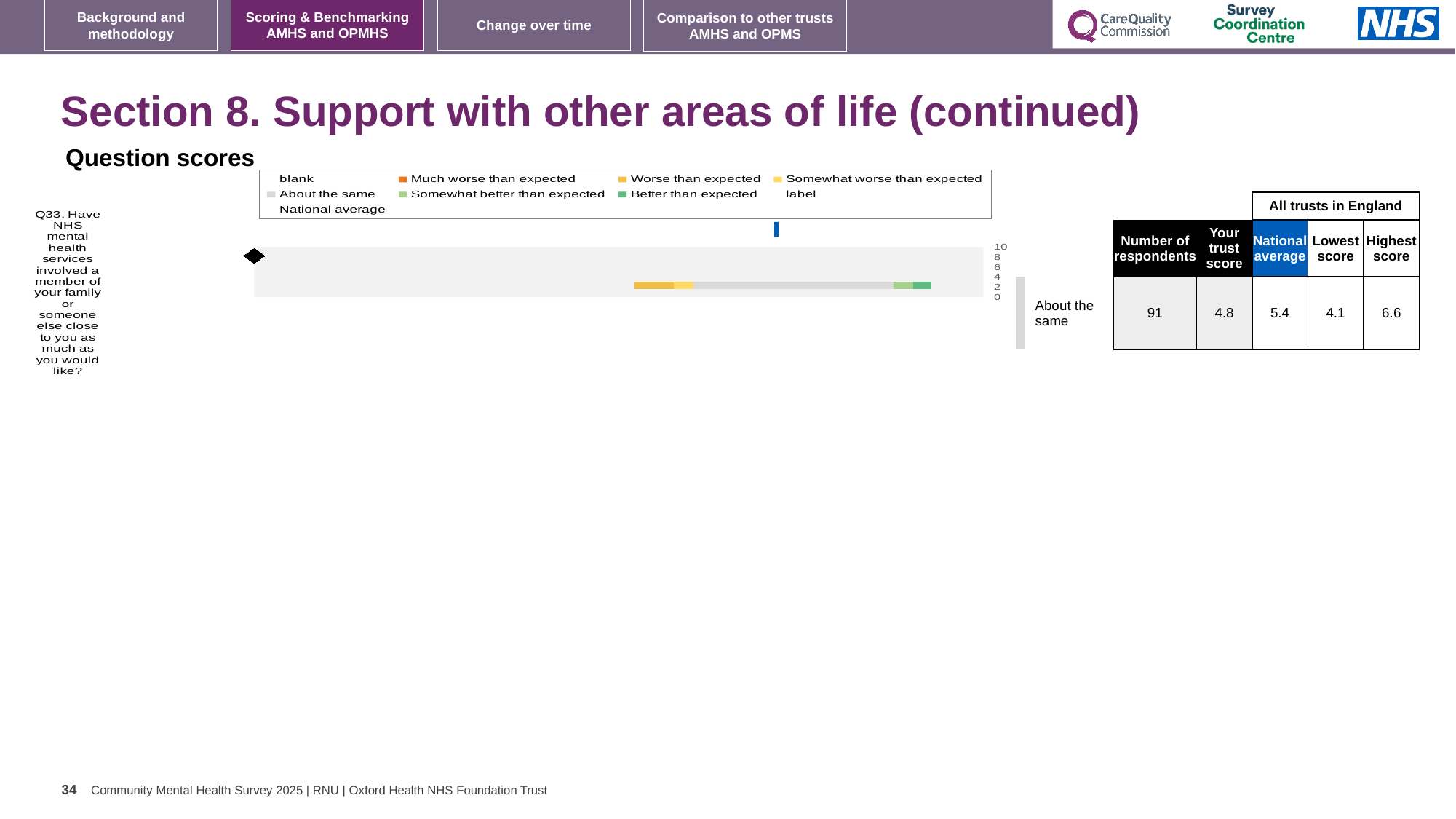
What is the highest tick value shown on the chart's axis? 10 In the table next to the chart, which is larger for Q33: your trust score or the national average? national average In the table next to the chart, what is the difference between the highest score and the lowest score for Q33? 2.5 In the table next to the chart, what is the number of respondents for Q33? 91 Which legend entry is shown in grey in the chart? About the same In the table next to the chart, what is the national average for Q33? 5.4 How many questions are plotted in the chart? 1 In the table next to the chart, what is 'Your trust score' for Q33? 4.8 What category label is printed to the right of the chart for Q33? About the same What kind of chart is shown under 'Question scores'? bar chart In the table next to the chart, what is the highest score among all trusts in England for Q33? 6.6 Which question number is plotted in the chart? Q33